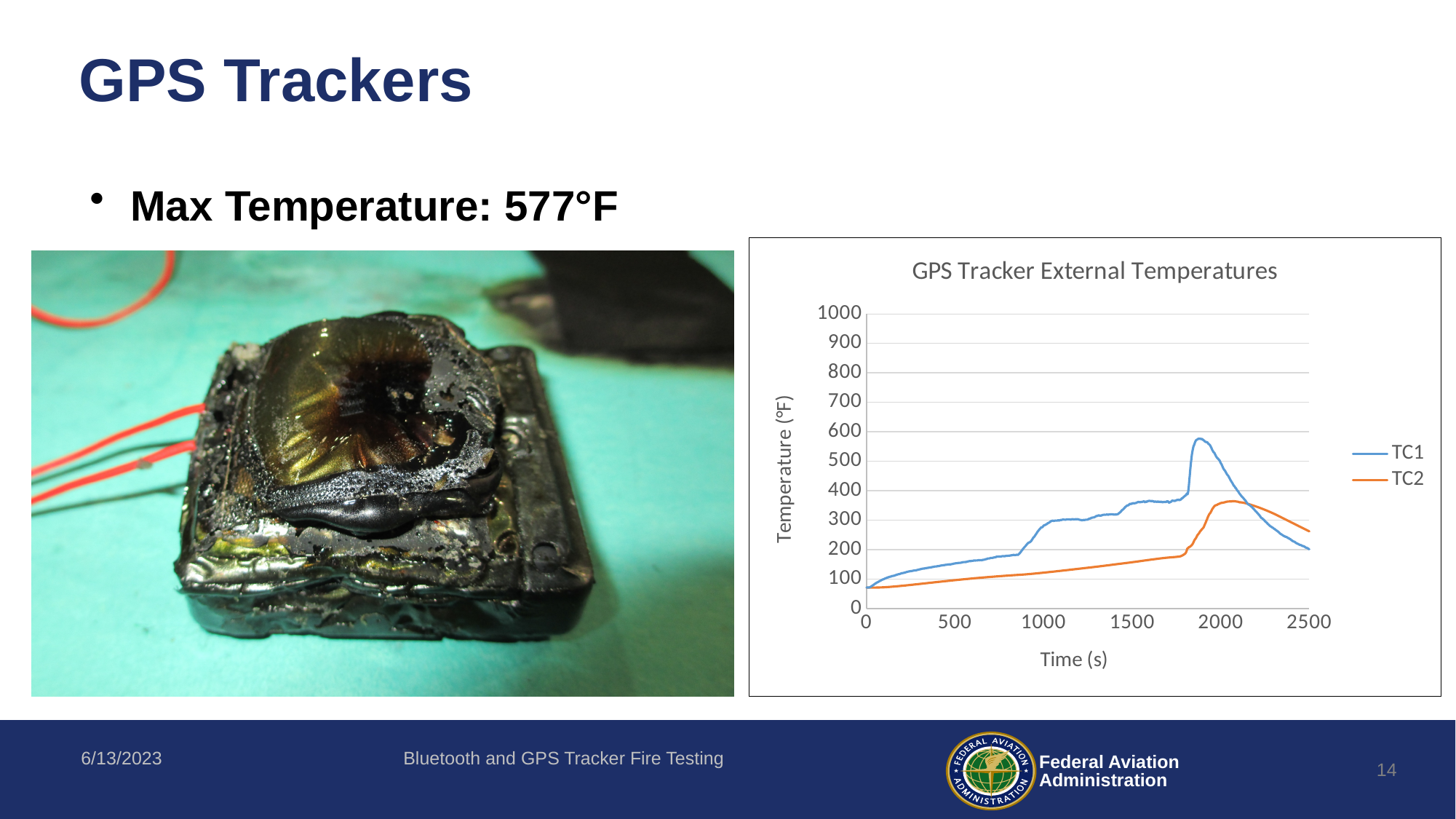
How many series does the legend of the chart list? 2 What are the two series named in the chart legend? TC1 and TC2 What kind of chart is shown on the slide? line chart Is the value of TC2 at 1500 s greater or less than 200? less Which series reaches the higher peak temperature, TC1 or TC2? TC1 What is the title of the chart? GPS Tracker External Temperatures Does the TC2 series rise or fall between 0 s and 2000 s? rise Is the peak value of TC2 greater or less than 400? less At 2500 s, which series has the higher temperature, TC1 or TC2? TC2 At 1000 s, which series has the higher temperature, TC1 or TC2? TC1 Is the peak value of TC1 greater or less than 500? greater